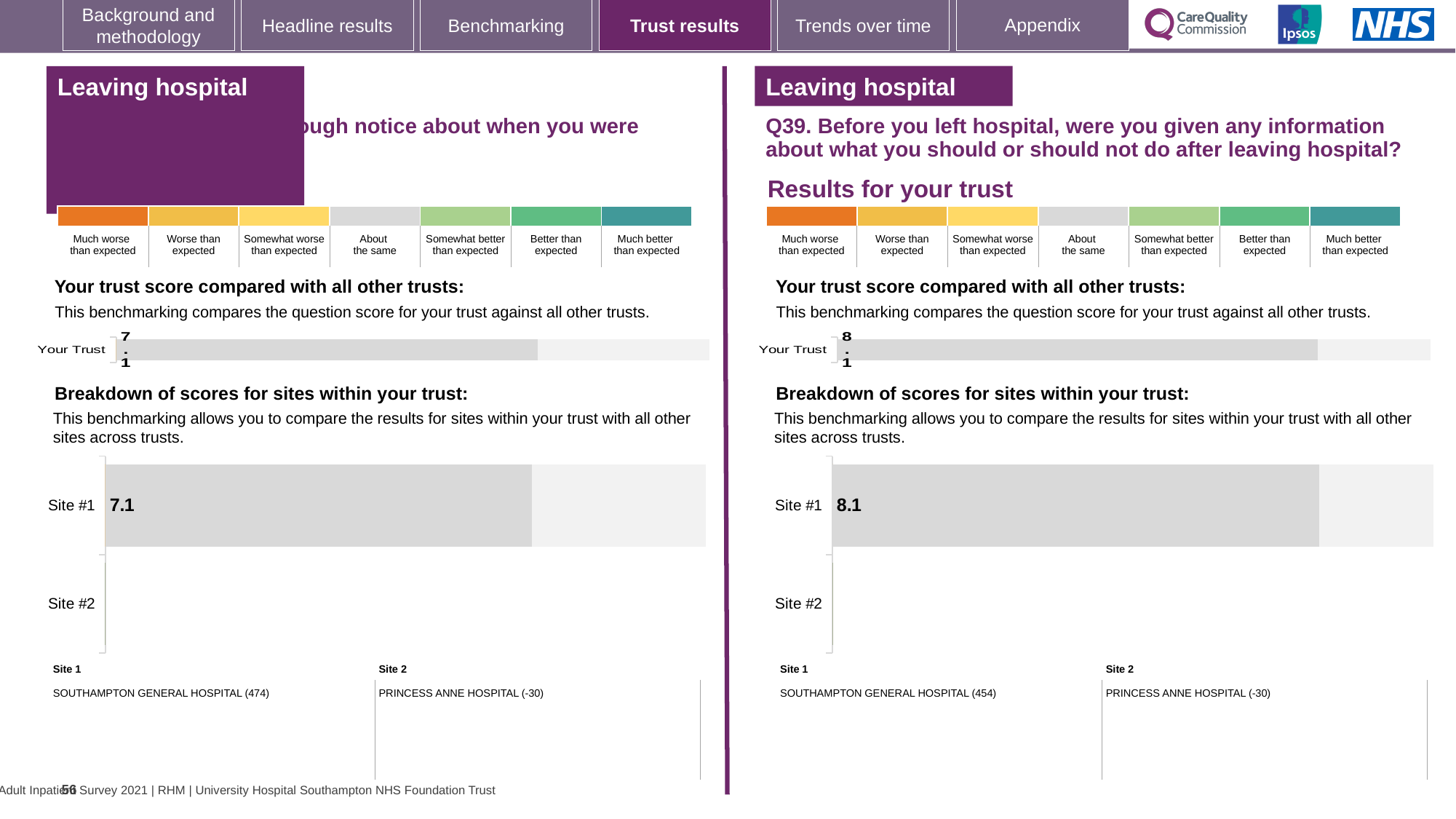
What type of chart is the left-hand 'Your trust score compared with all other trusts' chart? Bar chart What is the difference between the Site #1 score on the right-hand breakdown chart (Q39) and the Site #1 score on the left-hand breakdown chart? 1.0 On the right-hand breakdown chart (Q39), which hospital is listed as Site 1? SOUTHAMPTON GENERAL HOSPITAL (454) What type of chart is the right-hand 'Breakdown of scores for sites within your trust' chart (Q39)? Bar chart How many site categories are listed on the right-hand 'Breakdown of scores for sites within your trust' chart (Q39)? 2 On the right-hand 'Breakdown of scores for sites within your trust' chart (Q39), what is the score for Site #1? 8.1 On the right-hand breakdown chart (Q39), which site has the highest score? Site #1 How many site categories are listed on the left-hand 'Breakdown of scores for sites within your trust' chart? 2 On the left-hand 'Breakdown of scores for sites within your trust' chart, what is the score for Site #1? 7.1 Which is larger: the Your Trust score on the left-hand chart or the Your Trust score on the right-hand chart (Q39)? The right-hand chart (Q39) On the left-hand 'Your trust score compared with all other trusts' chart, what is the value shown for Your Trust? 7.1 On the right-hand 'Your trust score compared with all other trusts' chart (Q39), what is the value shown for Your Trust? 8.1